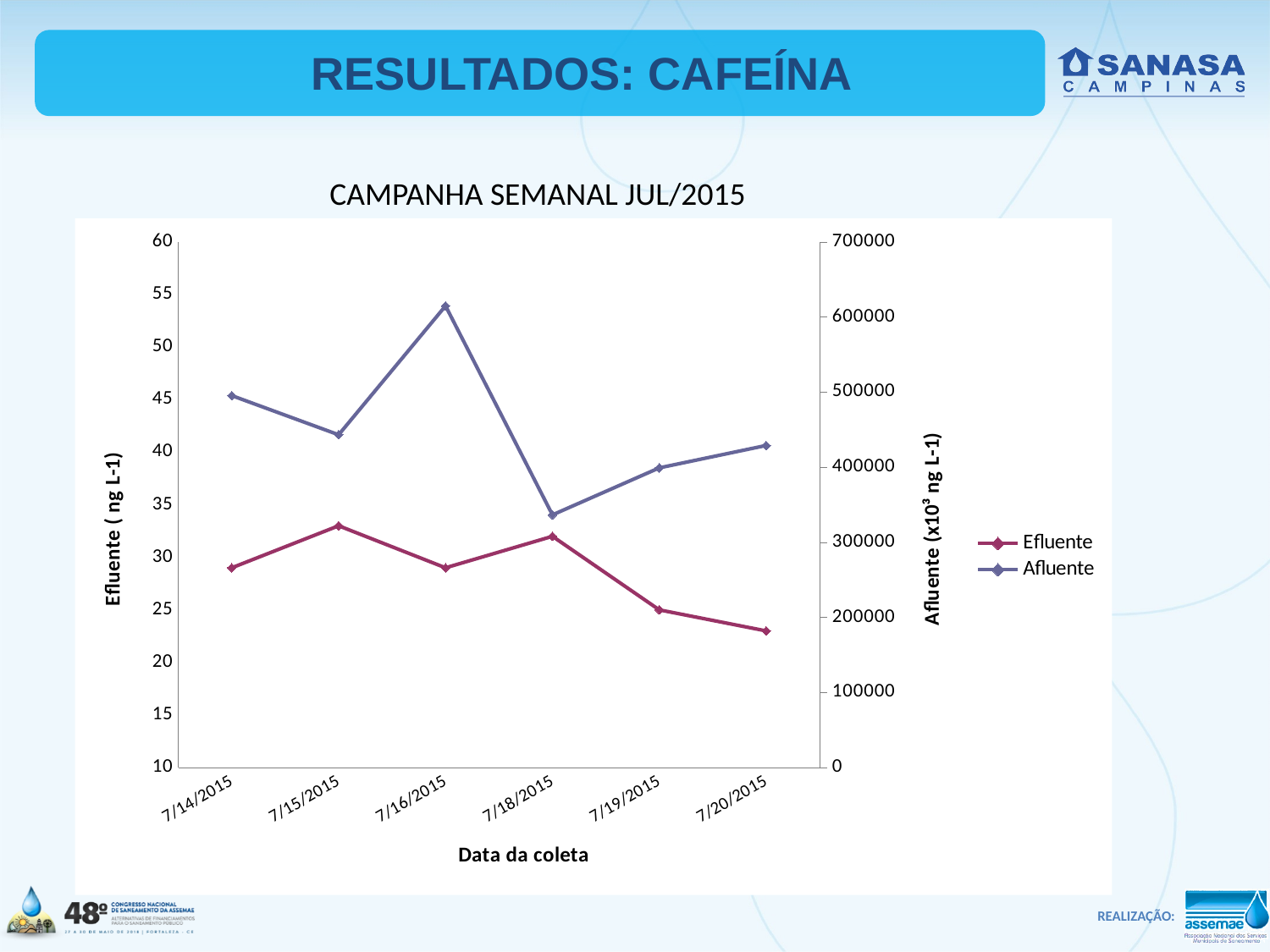
How many collection dates are plotted on the x axis? 6 On which date is the Afluente value highest? 7/16/2015 On which date is the Afluente value lowest? 7/18/2015 Does the Efluente series rise or fall from 7/18/2015 to 7/20/2015? fall Is the Afluente value for 7/18/2015 greater or less than 400000? less Is the Efluente value for 7/20/2015 greater or less than 25? less What kind of chart is shown on the slide? line chart Which is larger, the Afluente value for 7/14/2015 or for 7/15/2015? 7/14/2015 On which date is the Efluente value lowest? 7/20/2015 How many series does the legend list? 2 What is the label of the x axis? Data da coleta Is the Afluente value for 7/14/2015 greater or less than 400000? greater